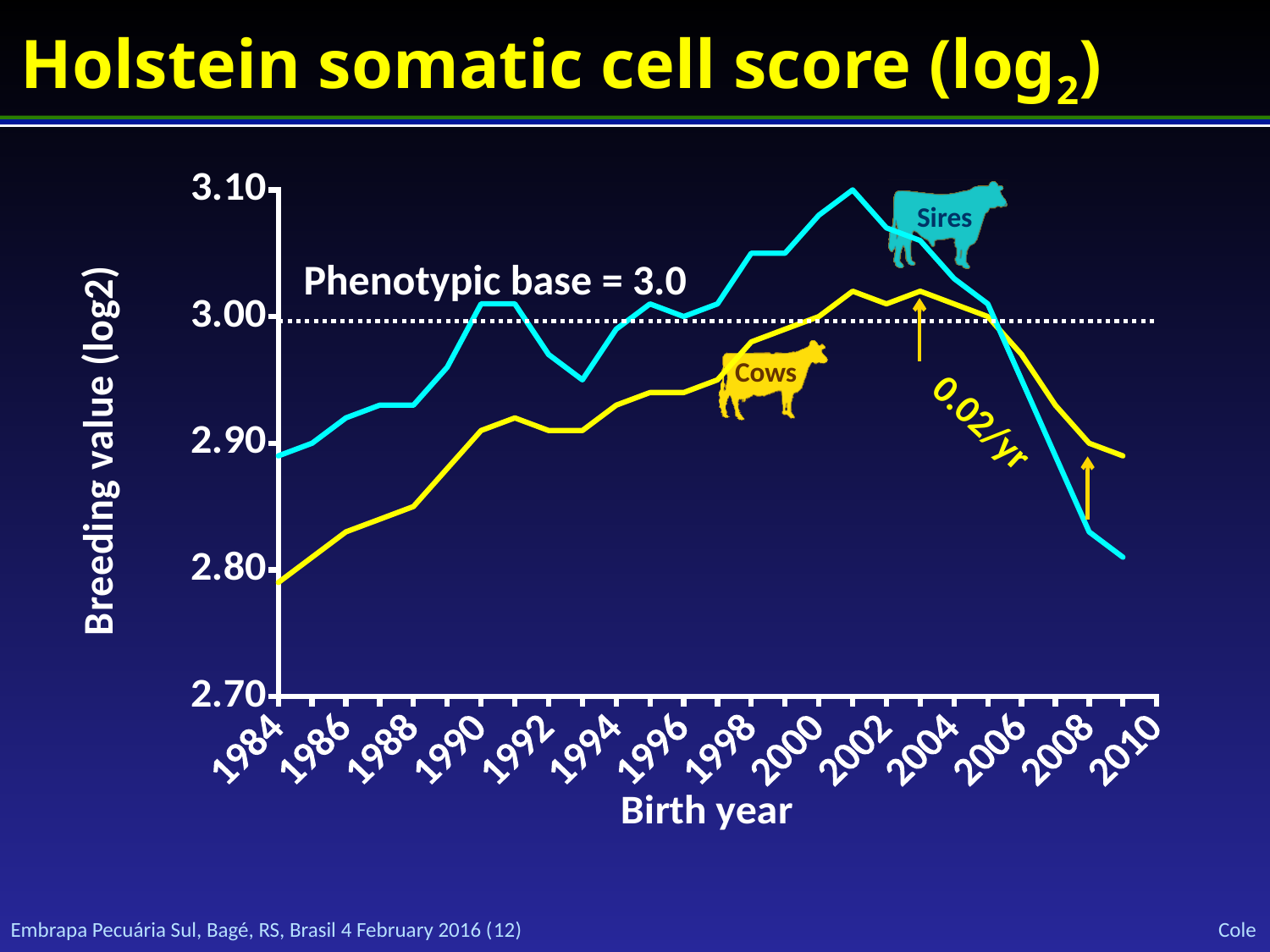
Is the Sires breeding value for birth year 2001 greater or less than 3.00? greater Does the Sires breeding value rise or fall between birth years 2001 and 2010? Fall Is the Cows breeding value for birth year 1984 greater or less than 2.90? less What kind of chart is shown on the slide? Line chart How many series are plotted in the chart? 2 What annual rate of change is annotated next to the declining part of the lines? 0.02/yr What value is the phenotypic base set to, according to the dotted reference line? 3.0 In birth year 1984, which series has the higher breeding value, Sires or Cows? Sires